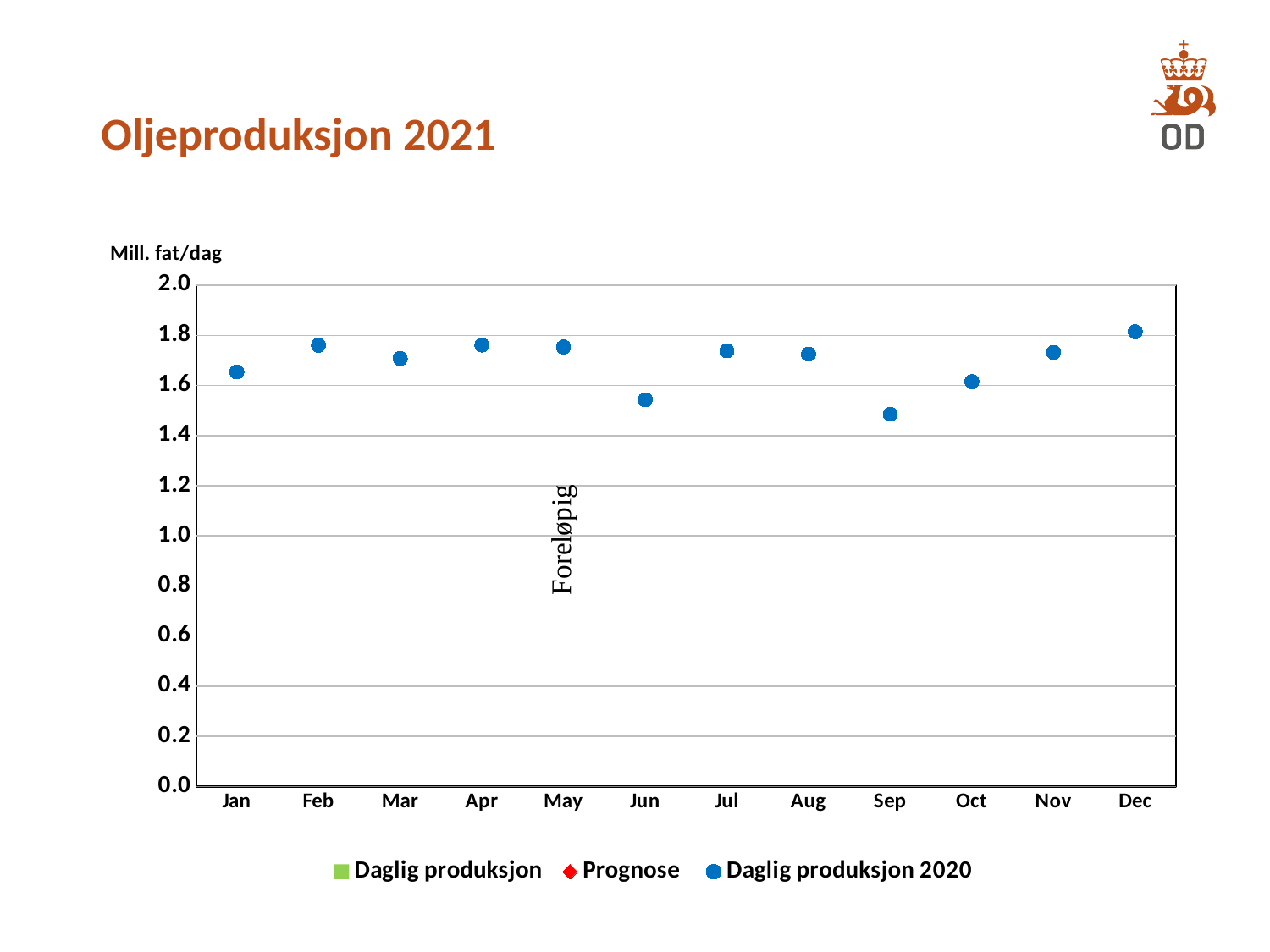
Is the value for Daglig produksjon 2020 in Sep greater or less than 1.6? less Is the value for Daglig produksjon 2020 in Feb greater or less than 1.6? greater What is the title of the chart on the slide? Oljeproduksjon 2021 How many months are plotted along the x axis of the chart? 12 What unit is shown on the y axis of the chart? Mill. fat/dag Which month has the lowest value for Daglig produksjon 2020? Sep Which month has the highest value for Daglig produksjon 2020? Dec Which month has the larger value for Daglig produksjon 2020, Jun or Sep? Jun Which month has the larger value for Daglig produksjon 2020, Jan or Feb? Feb How many series does the chart legend list? 3 What is the highest value shown on the y axis of the chart? 2.0 Is the value for Daglig produksjon 2020 in Jun greater or less than 1.6? less